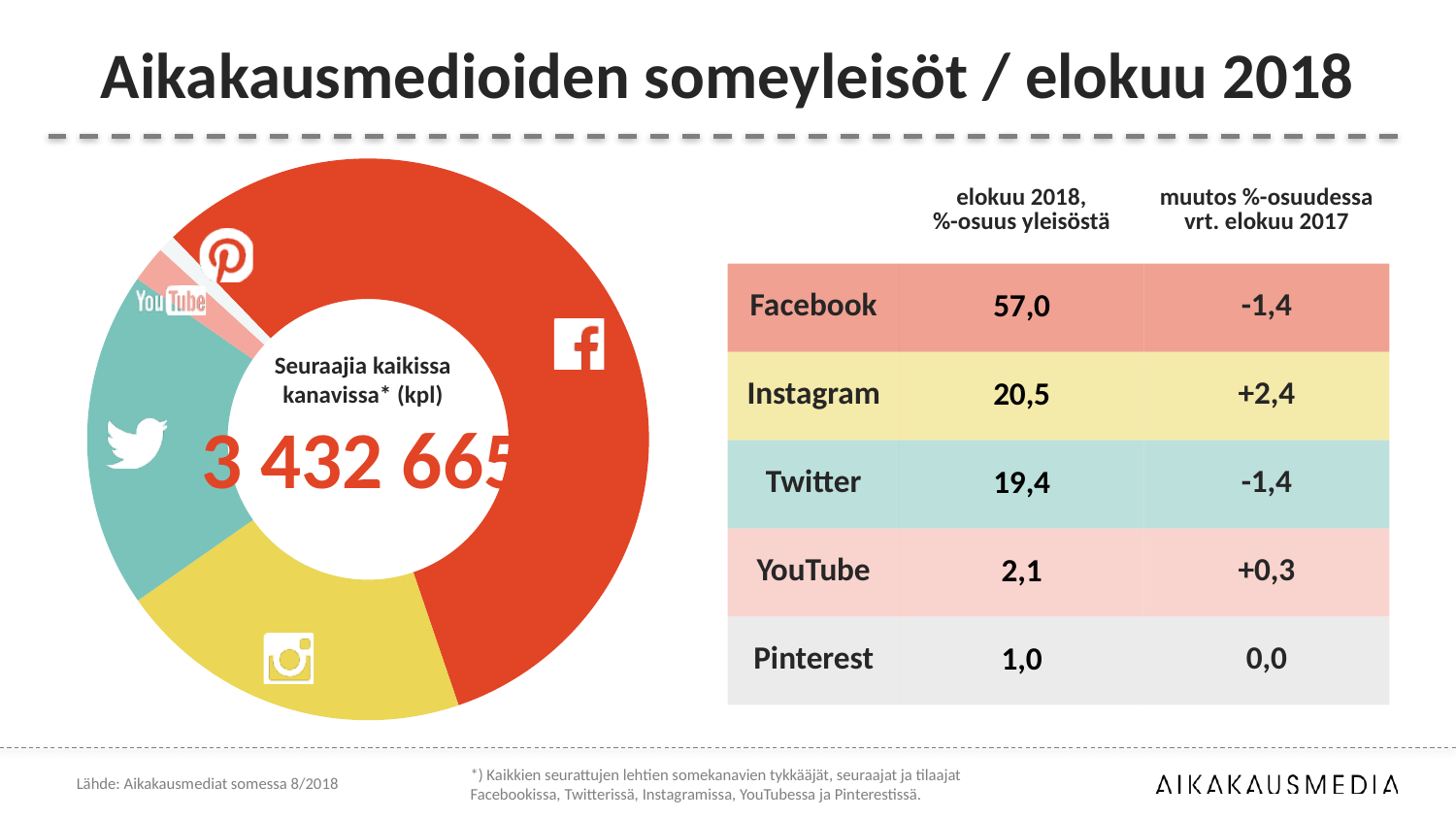
Which channel has the largest slice in the pie chart? Facebook What is Facebook's share of the audience in August 2018 (elokuu 2018, %-osuus yleisöstä)? 57,0 What is the difference between Facebook's and Instagram's share of the audience in August 2018? 36,5 Which has a larger share of the audience in August 2018, Facebook or Twitter? Facebook What is Instagram's share of the audience in August 2018? 20,5 What kind of chart is shown on the left of the slide? doughnut chart What is the change in percentage share for Instagram compared with August 2017? +2,4 What is the total number of followers across all channels shown in the centre of the pie chart? 3 432 665 What is the title of the slide? Aikakausmedioiden someyleisöt / elokuu 2018 Which channel has the smallest slice in the pie chart? Pinterest What is the change in percentage share for YouTube compared with August 2017? +0,3 How many social media channels are shown as slices in the pie chart? 5